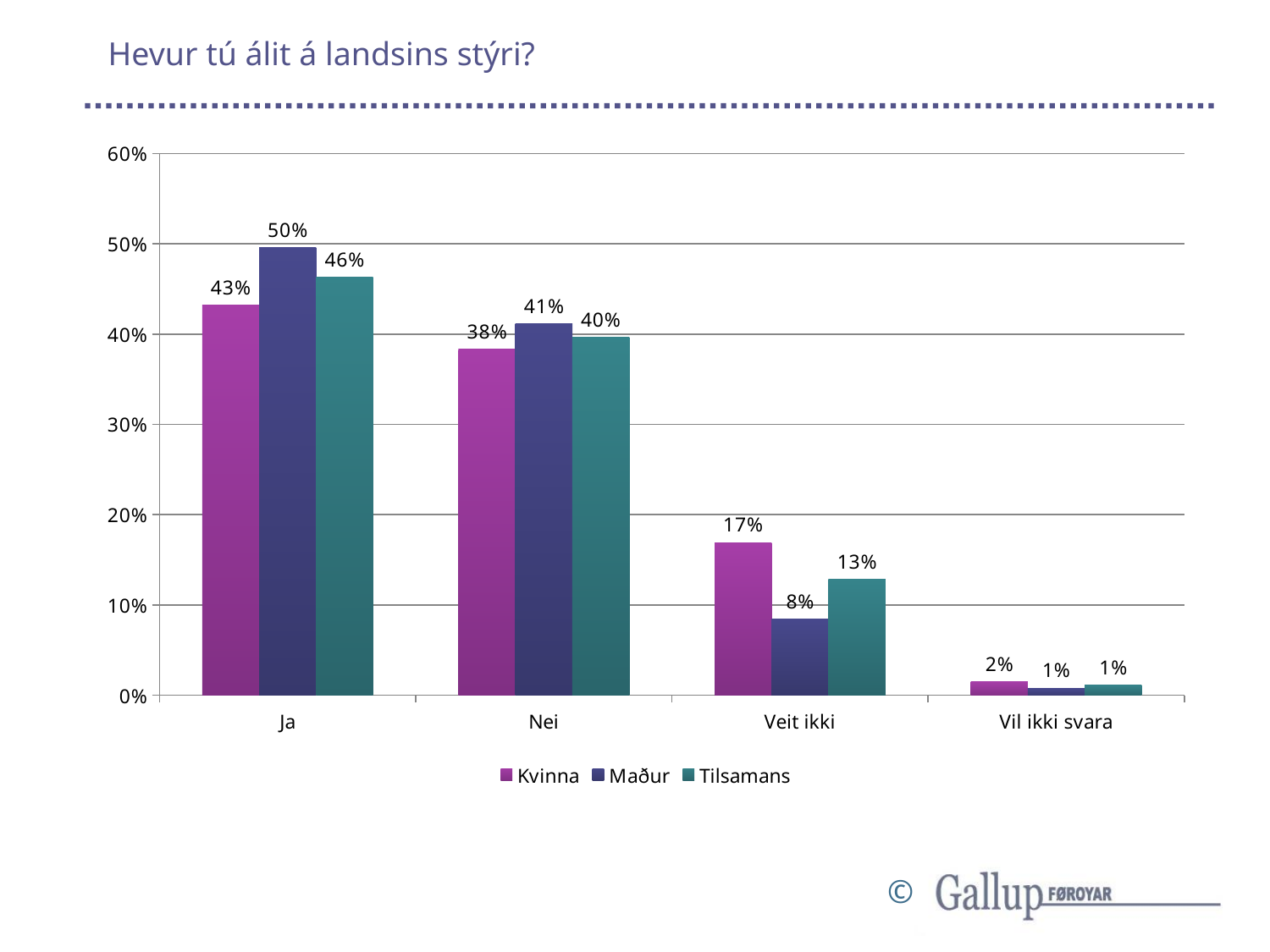
What is the value for Tilsamans in the Nei category? 40% What is the difference between the Maður and Kvinna values in the Ja category? 7% What is the value for Maður in the Ja category? 50% Is the value for Tilsamans in the Ja category greater or less than 40%? greater What kind of chart is shown on the slide? bar chart What is the title of the slide? Hevur tú álit á landsins stýri? How many categories are shown on the x axis? 4 Which category has the highest value for Kvinna? Ja In the Veit ikki category, which is larger: the value for Kvinna or the value for Maður? Kvinna How many series does the legend list? 3 What is the value for Kvinna in the Veit ikki category? 17% Which category has the lowest value for Tilsamans? Vil ikki svara